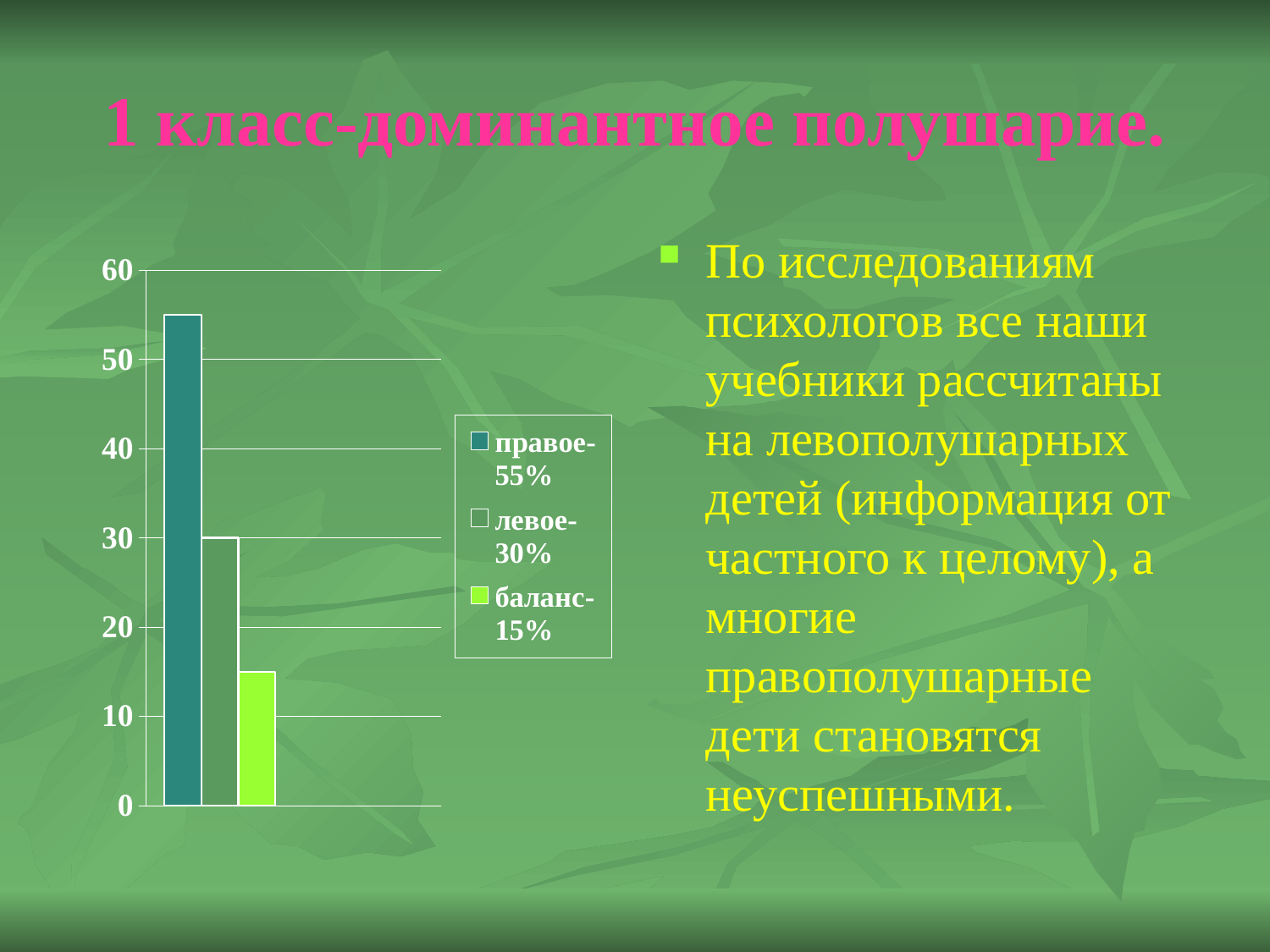
How many series does the chart legend list? 3 Which category has the lowest value in the chart? баланс What kind of chart is shown on the slide? bar chart Which is larger, the value for левое or the value for баланс? левое How many bars are plotted in the chart? 3 Is the value for правое greater or less than 50? greater Which category has the highest value in the chart? правое According to the legend, what is the value for правое? 55% According to the legend, what is the value for баланс? 15% What is the title of the slide containing the chart? 1 класс-доминантное полушарие. According to the legend, what is the value for левое? 30% What is the difference between the values for правое and левое? 25%